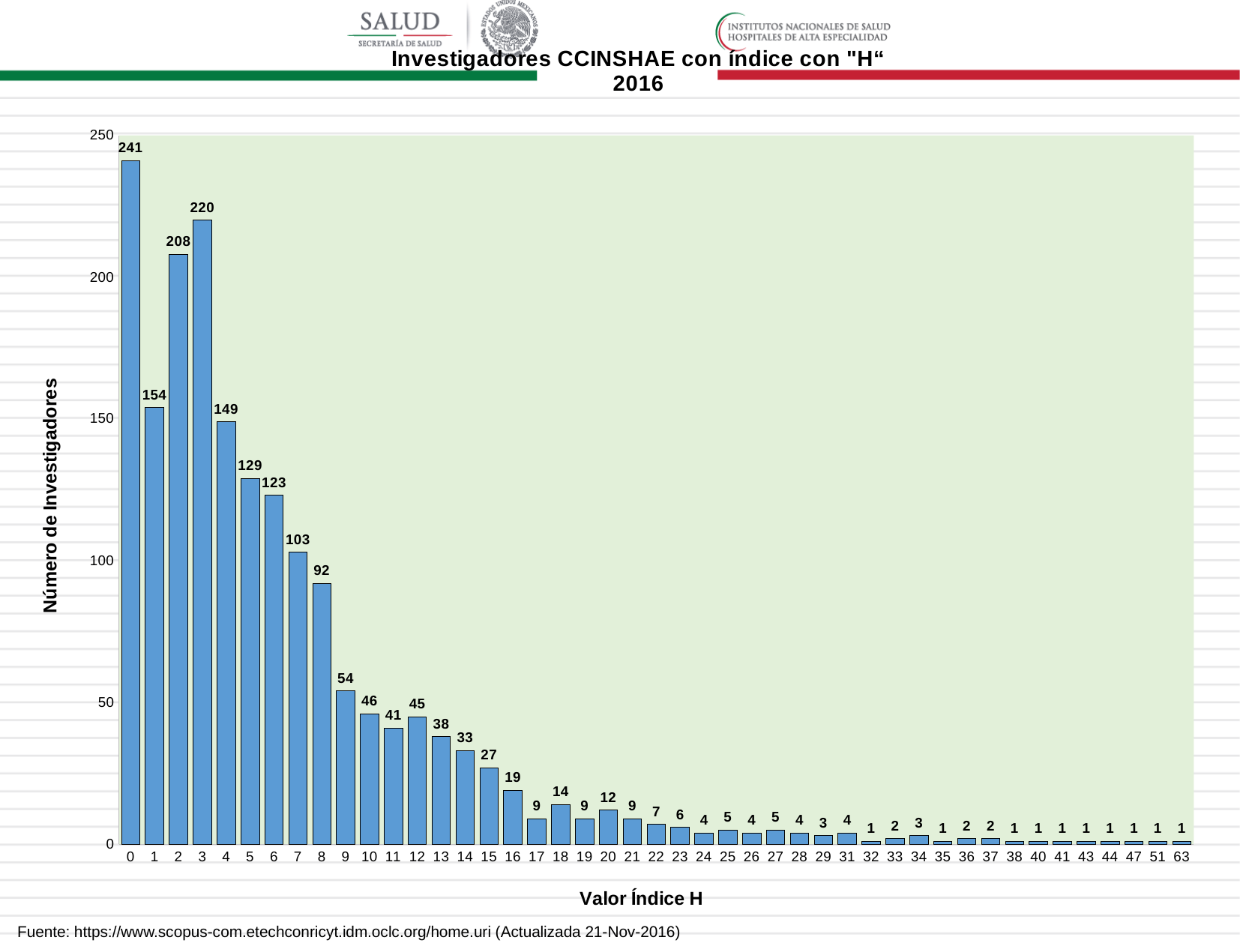
What is the number of investigators for H index value 18? 14 Which H index value has the highest number of investigators? 0 Do the values generally rise or fall as the H index value increases along the x axis? fall What is the lowest number of investigators shown for any H index value? 1 How many H index values (bars) are shown on the x axis? 45 What is the difference between the number of investigators with H index 2 and H index 1? 54 What type of chart is shown on the slide? bar chart How many investigators have an H index value of 0? 241 What is the number of investigators for H index value 9? 54 What is the number of investigators for H index value 3? 220 Which has more investigators: H index value 5 or H index value 6? H index value 5 What is the label of the y axis? Número de Investigadores